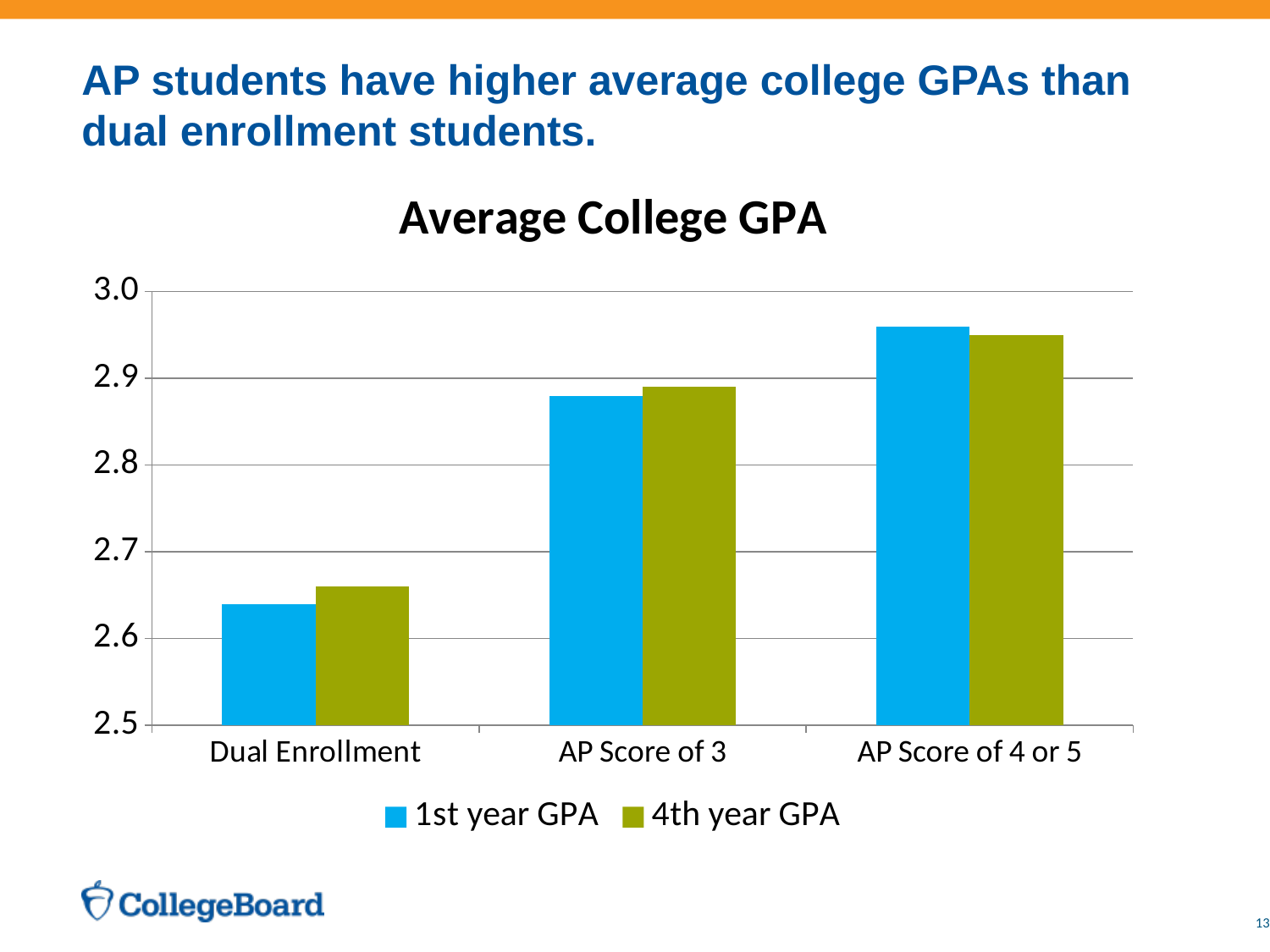
What kind of chart is shown on the slide? bar chart Is the 1st year GPA for Dual Enrollment greater or less than 2.7? less Which category has the highest 1st year GPA? AP Score of 4 or 5 Which category has the lowest 4th year GPA? Dual Enrollment Do the 1st year GPA values rise or fall moving from Dual Enrollment to AP Score of 4 or 5? rise What is the title of the chart? Average College GPA Is the 4th year GPA for AP Score of 4 or 5 greater or less than 2.9? greater Is the 1st year GPA for AP Score of 3 greater or less than 2.8? greater How many series does the legend list? 2 Which is larger, the 1st year GPA for AP Score of 3 or the 1st year GPA for Dual Enrollment? AP Score of 3 Which series is shown in green? 4th year GPA How many categories are shown on the x axis? 3